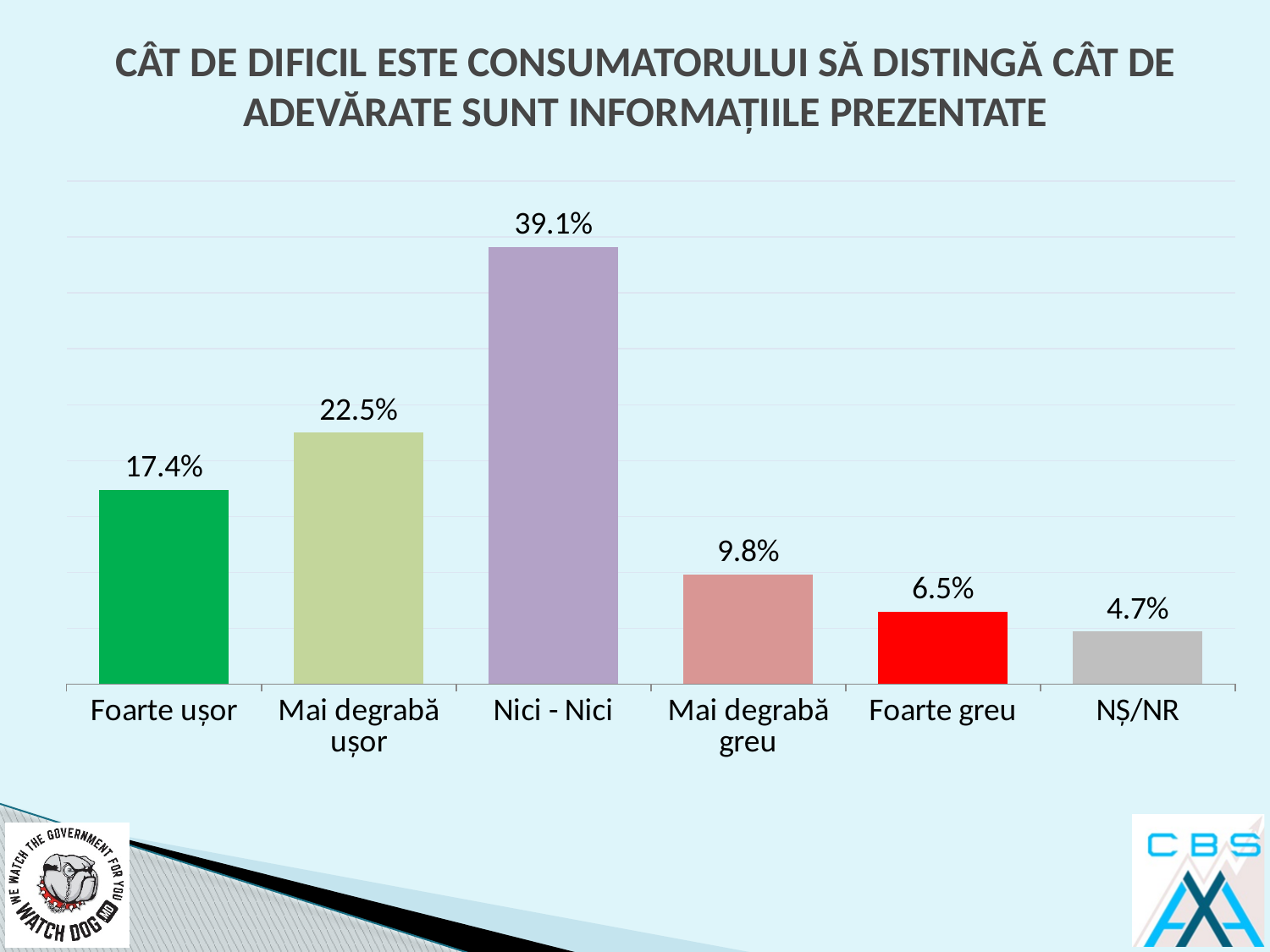
What is the value for "Nici - Nici"? 39.1% What is the difference between the values for "Nici - Nici" and "Mai degrabă greu"? 29.3% Which is larger, the value for "Foarte greu" or the value for "Mai degrabă greu"? Mai degrabă greu What is the value for "Foarte ușor"? 17.4% What kind of chart is shown on the slide? Bar chart How many categories are shown on the x axis? 6 Which category has the highest value? Nici - Nici What is the value for "NȘ/NR"? 4.7% What is the value for "Mai degrabă greu"? 9.8% Which category has the lowest value? NȘ/NR What colour is the bar for "Foarte greu"? Red What is the difference between the values for "Mai degrabă ușor" and "Foarte ușor"? 5.1%